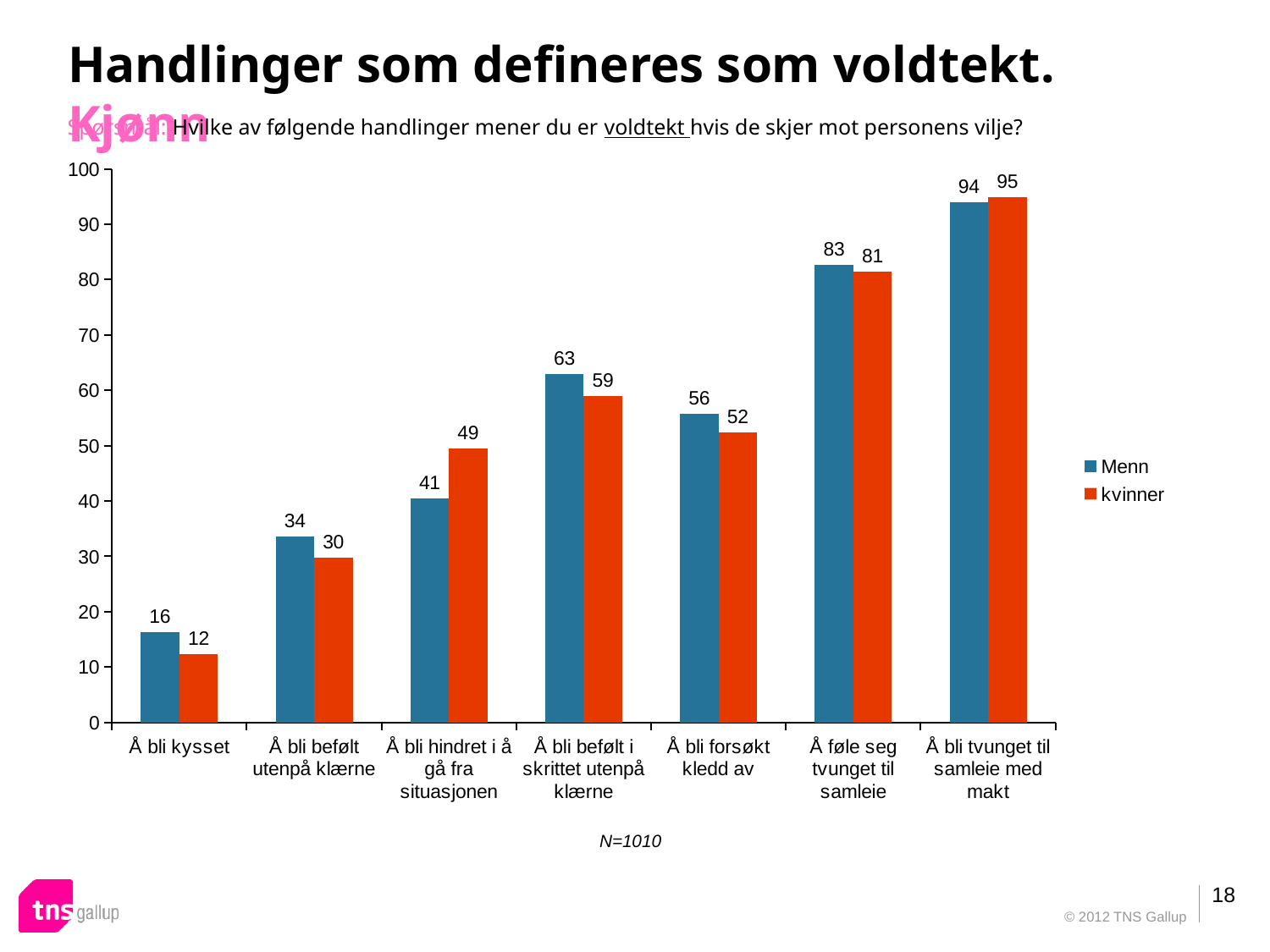
Is the value for kvinner for "Å føle seg tvunget til samleie" greater or less than 70? greater Which category has the lowest value for Menn? Å bli kysset What is the value for kvinner for "Å bli hindret i å gå fra situasjonen"? 49 What is the difference between the Menn and kvinner values for "Å bli forsøkt kledd av"? 4 Which category has the highest value for kvinner? Å bli tvunget til samleie med makt What sample size (N) is stated below the chart? N=1010 What is the value for Menn for "Å bli befølt i skrittet utenpå klærne"? 63 For "Å bli hindret i å gå fra situasjonen", which series has the larger value, Menn or kvinner? kvinner What is the value for Menn for "Å bli kysset"? 16 How many series does the legend list? 2 What kind of chart is shown on the slide? Bar chart How many categories are shown on the x axis? 7